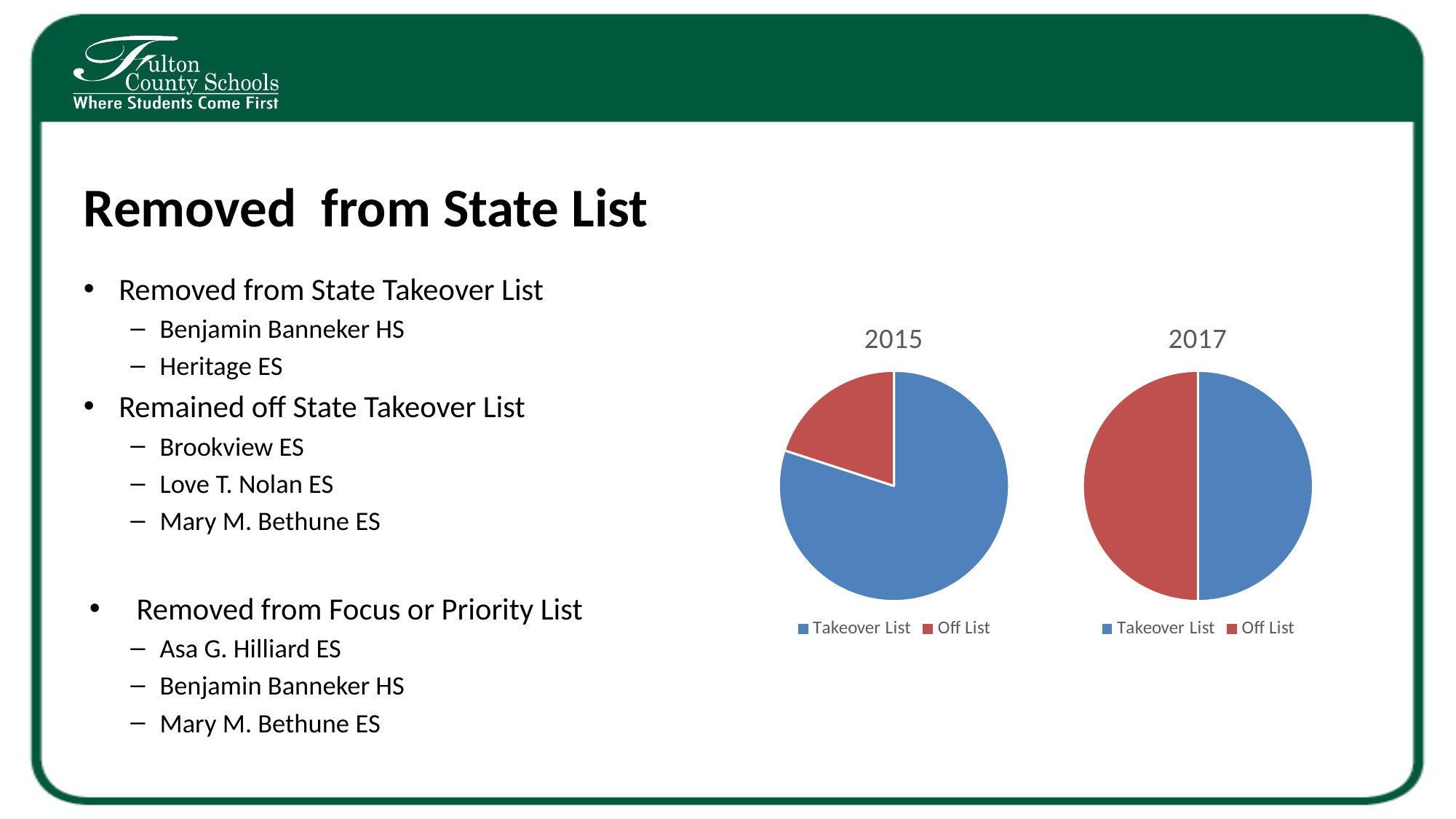
How many slices does the 2015 pie chart have? 2 What colour represents Off List in the 2017 pie chart? red How many entries does the legend of the 2015 chart list? 2 In the 2015 pie chart, which slice is larger, Takeover List or Off List? Takeover List In the 2015 pie chart, which category has the smallest slice? Off List How many pie charts are shown on the slide? 2 In the 2015 pie chart, which category has the largest slice? Takeover List How many slices does the 2017 pie chart have? 2 What are the two legend entries of the 2017 chart? Takeover List, Off List What kind of chart is the 2017 chart? pie chart What kind of chart is the 2015 chart? pie chart